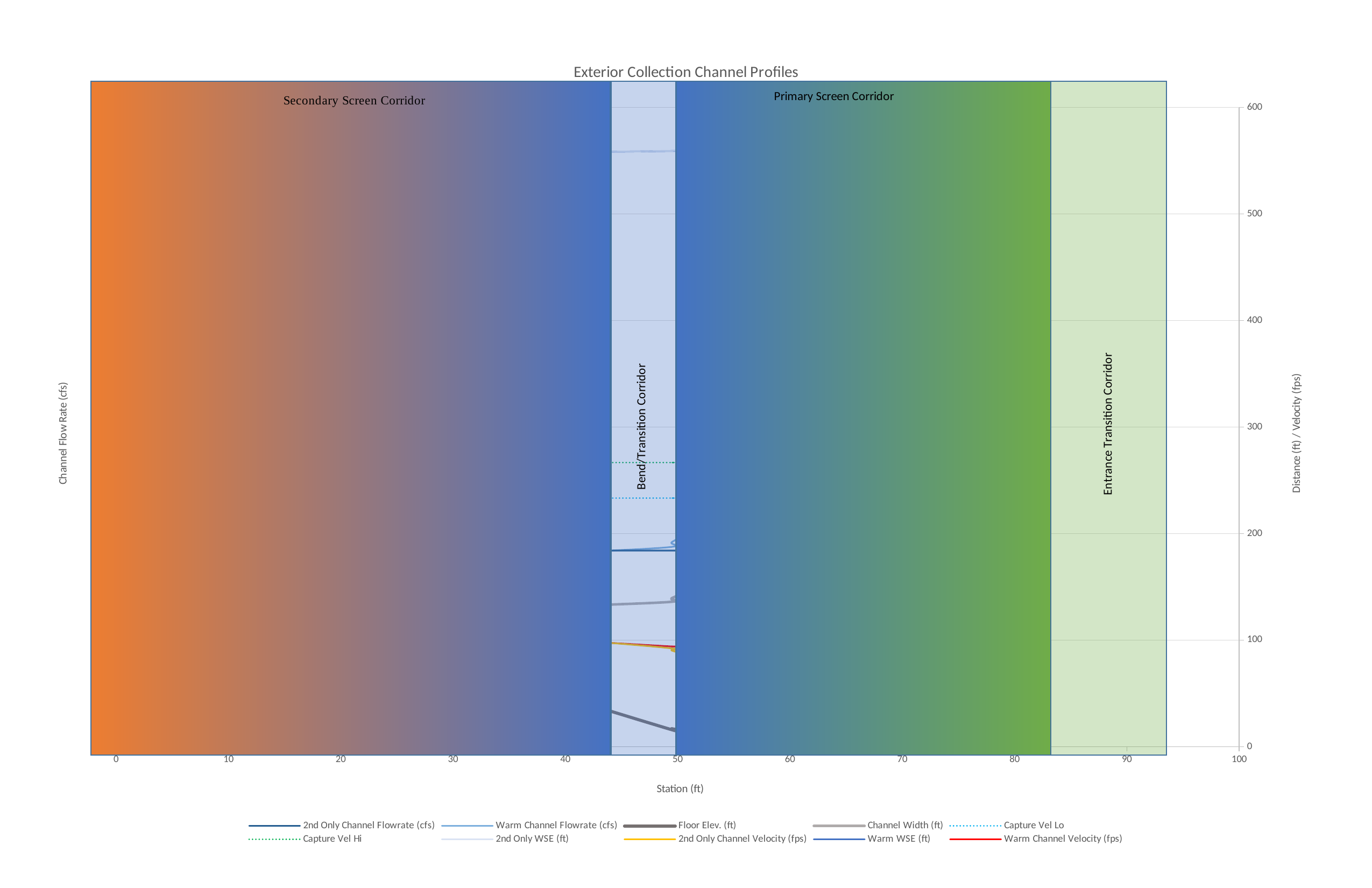
Is the Floor Elev. (ft) line greater or less than 100 on the right-hand axis in the visible Bend/Transition Corridor section? less How many series does the chart's legend list? 10 What is the label of the x axis? Station (ft) Is the 2nd Only Channel Flowrate (cfs) line greater or less than 300 on the right-hand axis in the visible Bend/Transition Corridor section? less What kind of chart is shown on the slide? line chart What is the title of the chart? Exterior Collection Channel Profiles Is the value of the Capture Vel Lo line greater or less than 300 on the right-hand axis? less Which line is plotted higher, Capture Vel Hi or Capture Vel Lo? Capture Vel Hi Which line is plotted higher in the visible Bend/Transition Corridor section, Floor Elev. (ft) or Channel Width (ft)? Channel Width (ft)